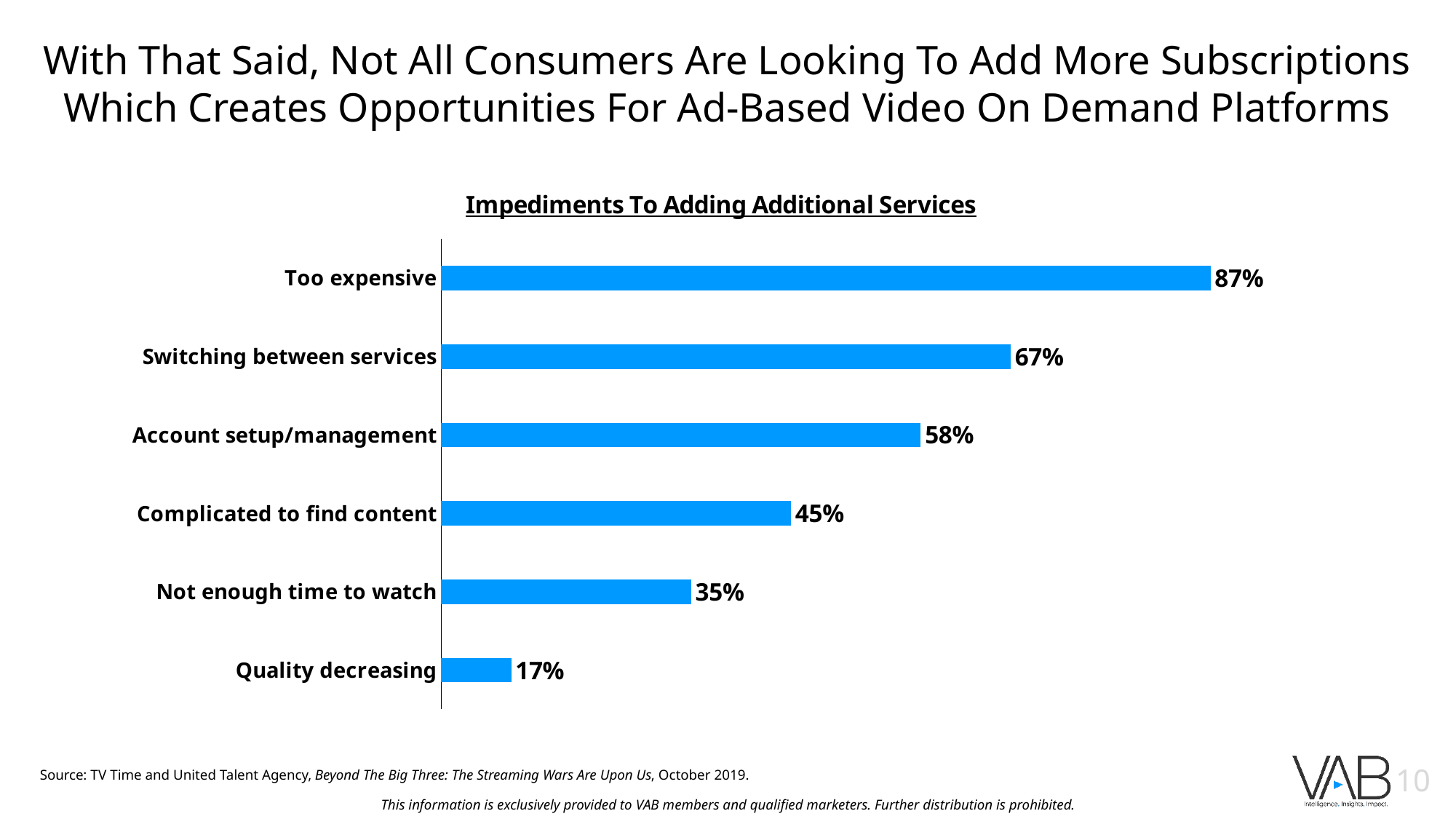
What is the title of the chart? Impediments To Adding Additional Services What percentage of respondents cited "Too expensive" as an impediment to adding additional services? 87% Which impediment has the lowest percentage? Quality decreasing How many impediments are listed in the chart? 6 What type of chart is used on this slide? Bar chart Which is larger: the value for "Switching between services" or the value for "Account setup/management"? Switching between services Do the values increase or decrease from the top bar to the bottom bar? Decrease What is the value shown for "Account setup/management"? 58% What is the value shown for "Not enough time to watch"? 35% Which impediment has the highest percentage? Too expensive What is the difference in percentage points between "Complicated to find content" and "Quality decreasing"? 28 percentage points What is the difference in percentage points between "Too expensive" and "Switching between services"? 20 percentage points